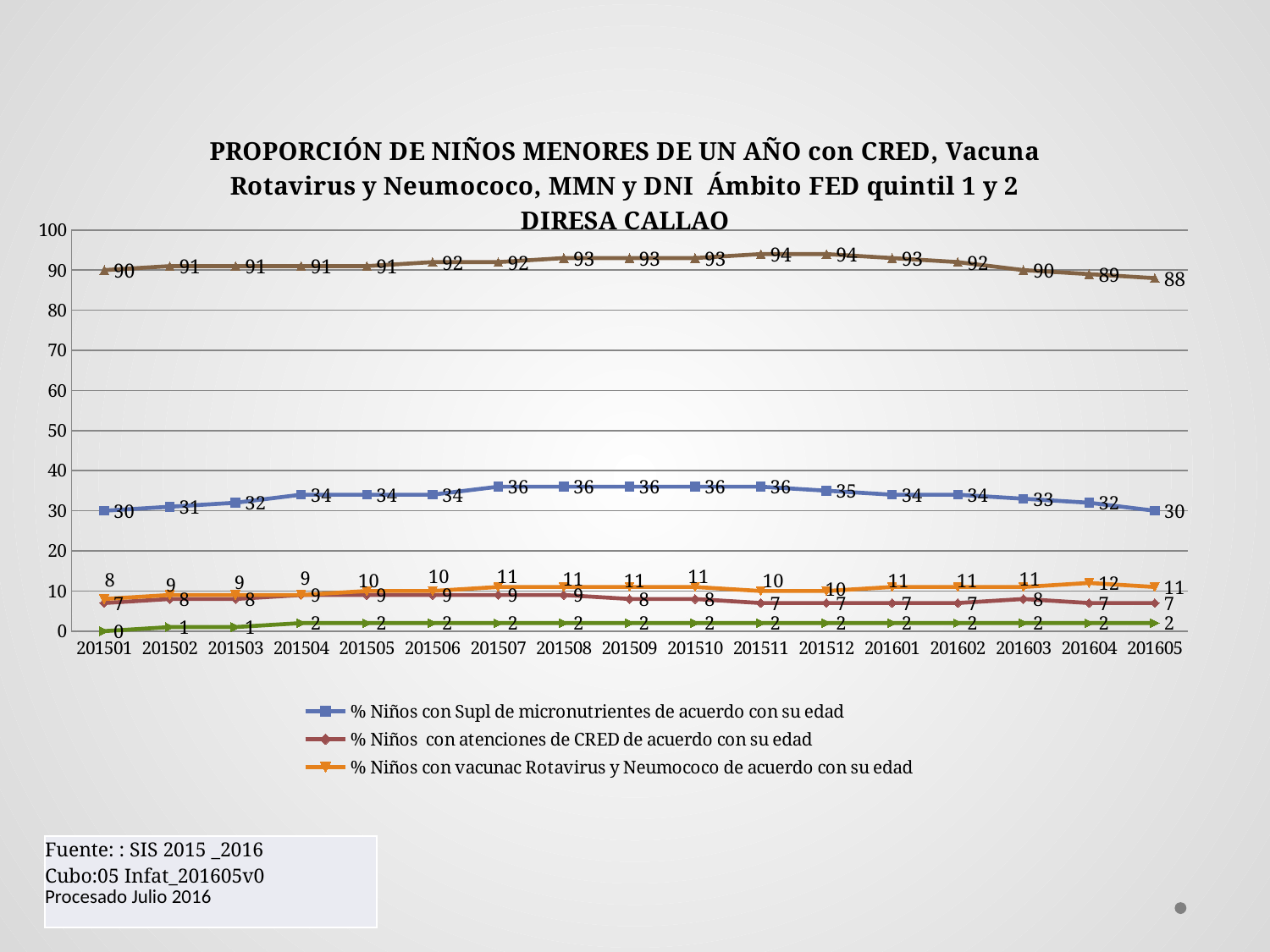
What is the value for '% Niños con Supl de micronutrientes de acuerdo con su edad' at 201507? 36 Does '% Niños con Supl de micronutrientes de acuerdo con su edad' rise or fall from 201511 to 201605? fall What is the difference between the '% Niños con Supl de micronutrientes de acuerdo con su edad' values at 201511 and 201605? 6 How many series does the legend list? 3 In which period does '% Niños con vacunac Rotavirus y Neumococo de acuerdo con su edad' reach its highest value? 201604 Which DIRESA is named in the chart title? DIRESA CALLAO What is the value for '% Niños con vacunac Rotavirus y Neumococo de acuerdo con su edad' at 201604? 12 What is the value for '% Niños con atenciones de CRED de acuerdo con su edad' at 201501? 7 What kind of chart is shown on the slide? line chart How many time periods are plotted along the x axis? 17 Is the value for '% Niños con Supl de micronutrientes de acuerdo con su edad' at 201510 greater or less than 30? greater At 201601, which is larger: '% Niños con vacunac Rotavirus y Neumococo de acuerdo con su edad' or '% Niños con atenciones de CRED de acuerdo con su edad'? % Niños con vacunac Rotavirus y Neumococo de acuerdo con su edad